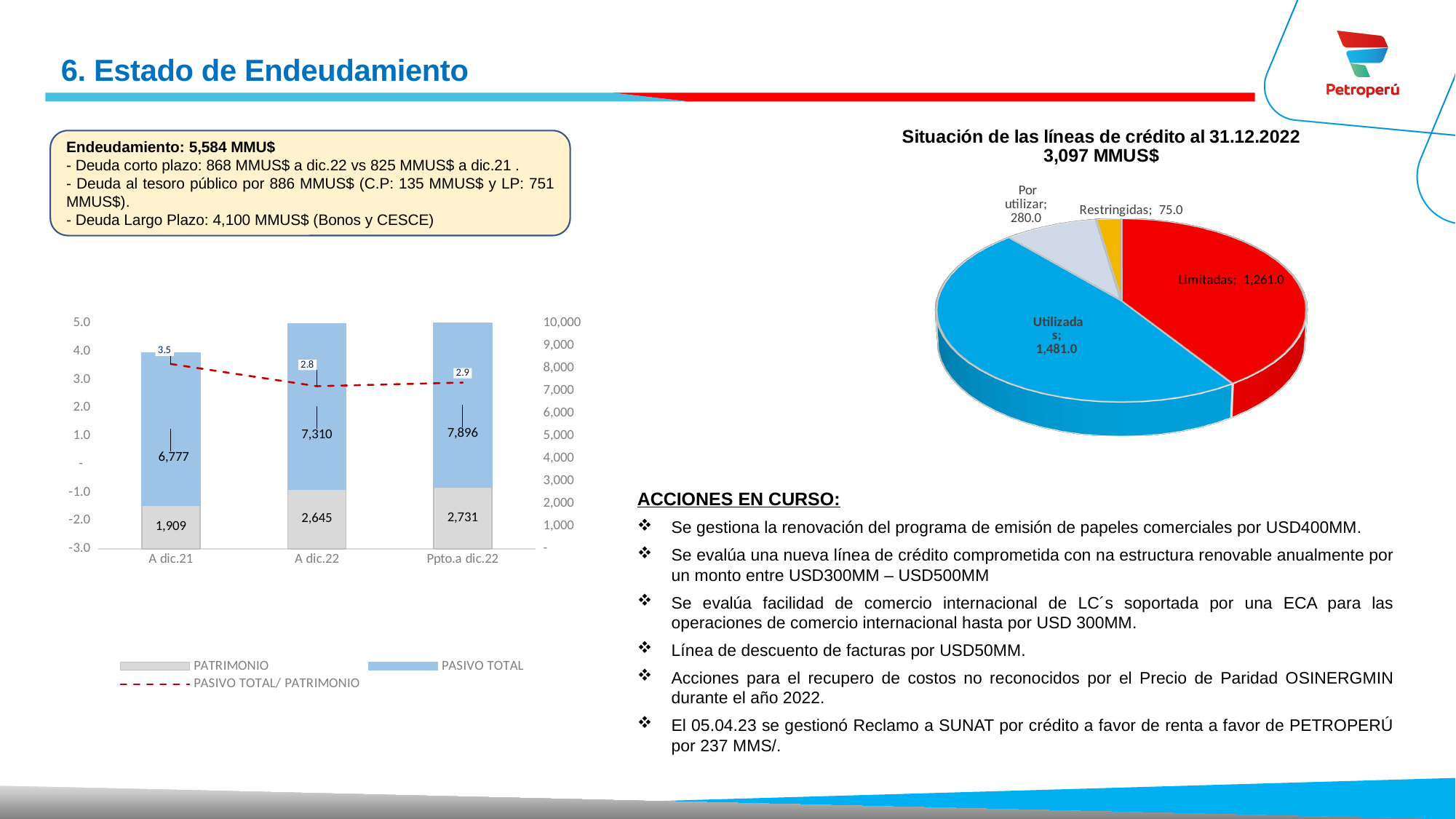
In the stacked bar chart on the left, what is the difference in PASIVO TOTAL between Ppto.a dic.22 and A dic.22? 586 In the stacked bar chart on the left, what is the PASIVO TOTAL/ PATRIMONIO ratio for Ppto.a dic.22? 2.9 In the pie chart 'Situación de las líneas de crédito al 31.12.2022', which slice is the largest? Utilizadas In the stacked bar chart on the left, what is the PASIVO TOTAL value for A dic.22? 7,310 In the stacked bar chart on the left, what is the total of the stacked bar for A dic.21 (PATRIMONIO plus PASIVO TOTAL)? 8,686 In the pie chart 'Situación de las líneas de crédito al 31.12.2022', what is the value for Utilizadas? 1,481.0 In the pie chart 'Situación de las líneas de crédito al 31.12.2022', what is the difference between Utilizadas and Limitadas? 220.0 In the stacked bar chart on the left, what is the PATRIMONIO value for A dic.21? 1,909 In the pie chart 'Situación de las líneas de crédito al 31.12.2022', which slice is the smallest? Restringidas In the pie chart 'Situación de las líneas de crédito al 31.12.2022', what is the value for Restringidas? 75.0 In the pie chart 'Situación de las líneas de crédito al 31.12.2022', how many slices are there? 4 In the stacked bar chart on the left, how many series does the legend list? 3